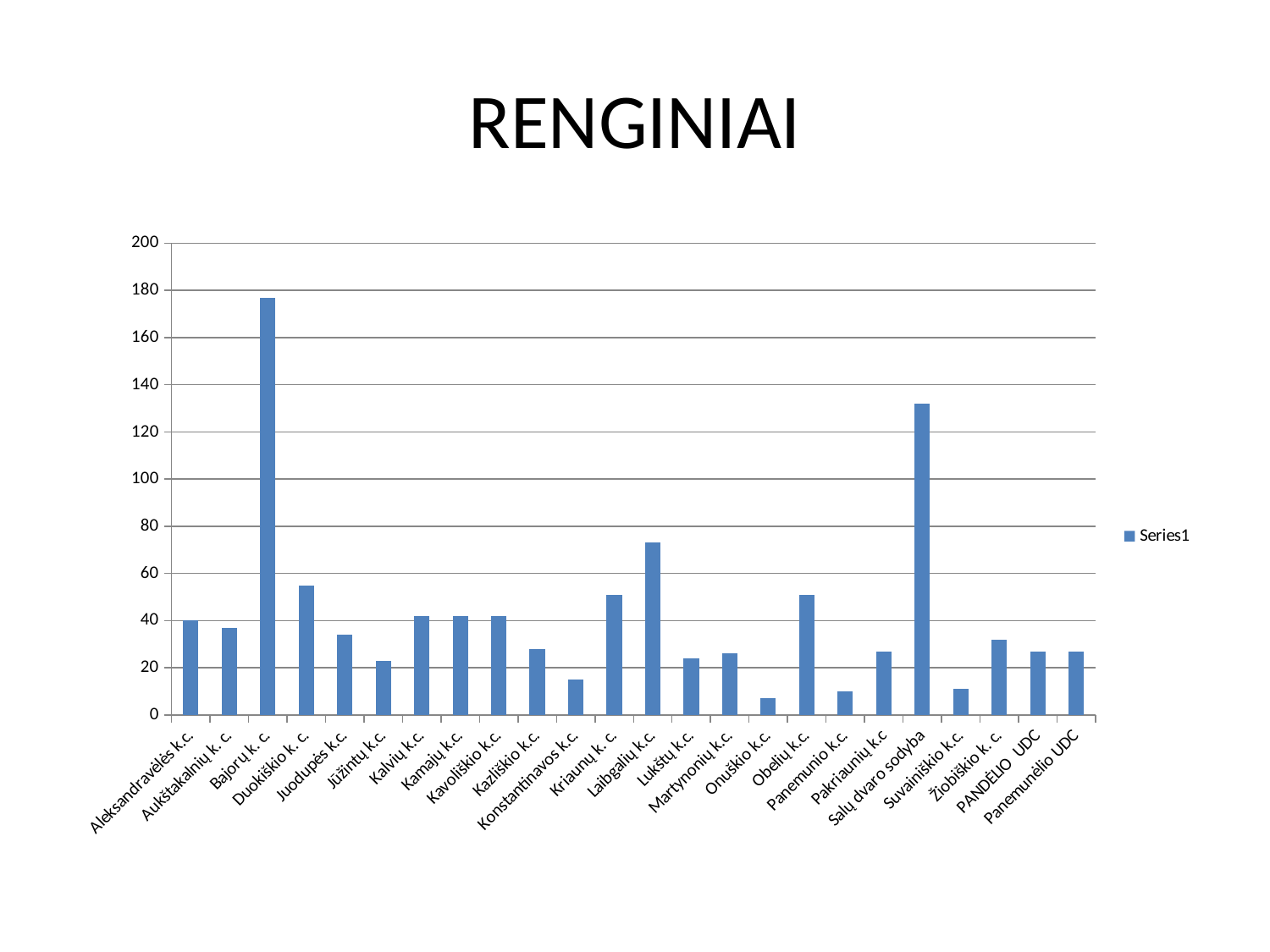
Which category has the lowest value? Onuškio k.c. Is the value for Laibgalių k.c. greater or less than 60? greater What is the title of the chart? RENGINIAI What kind of chart is shown on the slide? bar chart How many series does the legend list? 1 Is the value for Salų dvaro sodyba greater or less than 120? greater Which is larger, the value for Bajorų k. c. or the value for Salų dvaro sodyba? Bajorų k. c. Which category has the highest value? Bajorų k. c. Is the value for Bajorų k. c. greater or less than 160? greater Which is larger, the value for Laibgalių k.c. or the value for Kriaunų k. c.? Laibgalių k.c. How many categories are shown on the x axis? 24